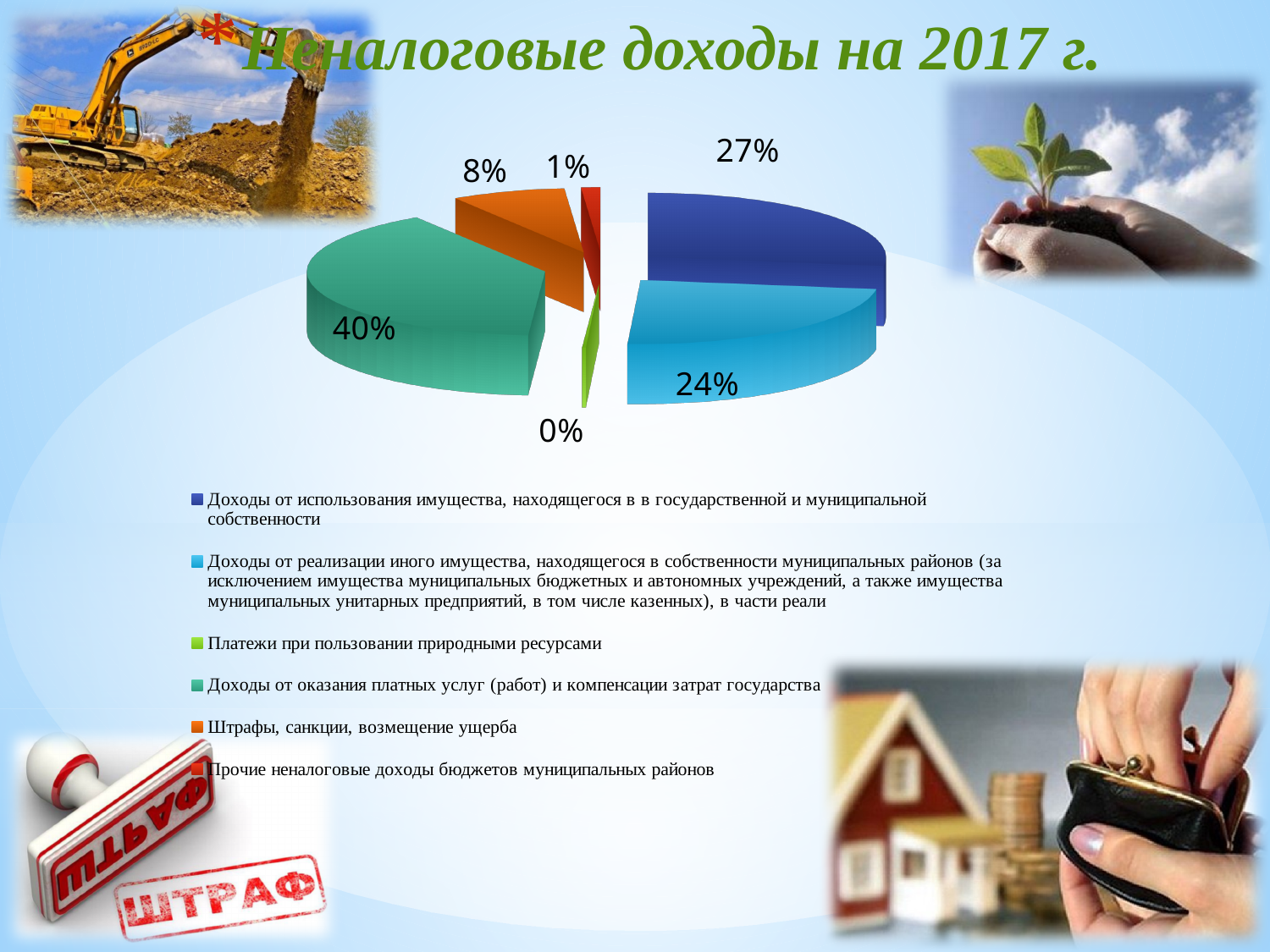
What kind of chart is shown on the slide? pie chart What share of the pie is labelled for "Доходы от использования имущества, находящегося в государственной и муниципальной собственности"? 27% How many categories does the legend list? 6 Which category has the largest slice of the pie? Доходы от оказания платных услуг (работ) и компенсации затрат государства What share of the pie is labelled for "Прочие неналоговые доходы бюджетов муниципальных районов"? 1% Which is larger: the slice for "Доходы от использования имущества" or the slice for "Доходы от реализации иного имущества"? Доходы от использования имущества What share of the pie is labelled for "Штрафы, санкции, возмещение ущерба"? 8% What is the difference between the 40% slice and the 24% slice? 16% What share of the pie is labelled for "Платежи при пользовании природными ресурсами"? 0% Which category has the smallest slice of the pie? Платежи при пользовании природными ресурсами What is the title of the chart? Неналоговые доходы на 2017 г. What share of the pie is labelled for "Доходы от оказания платных услуг (работ) и компенсации затрат государства"? 40%